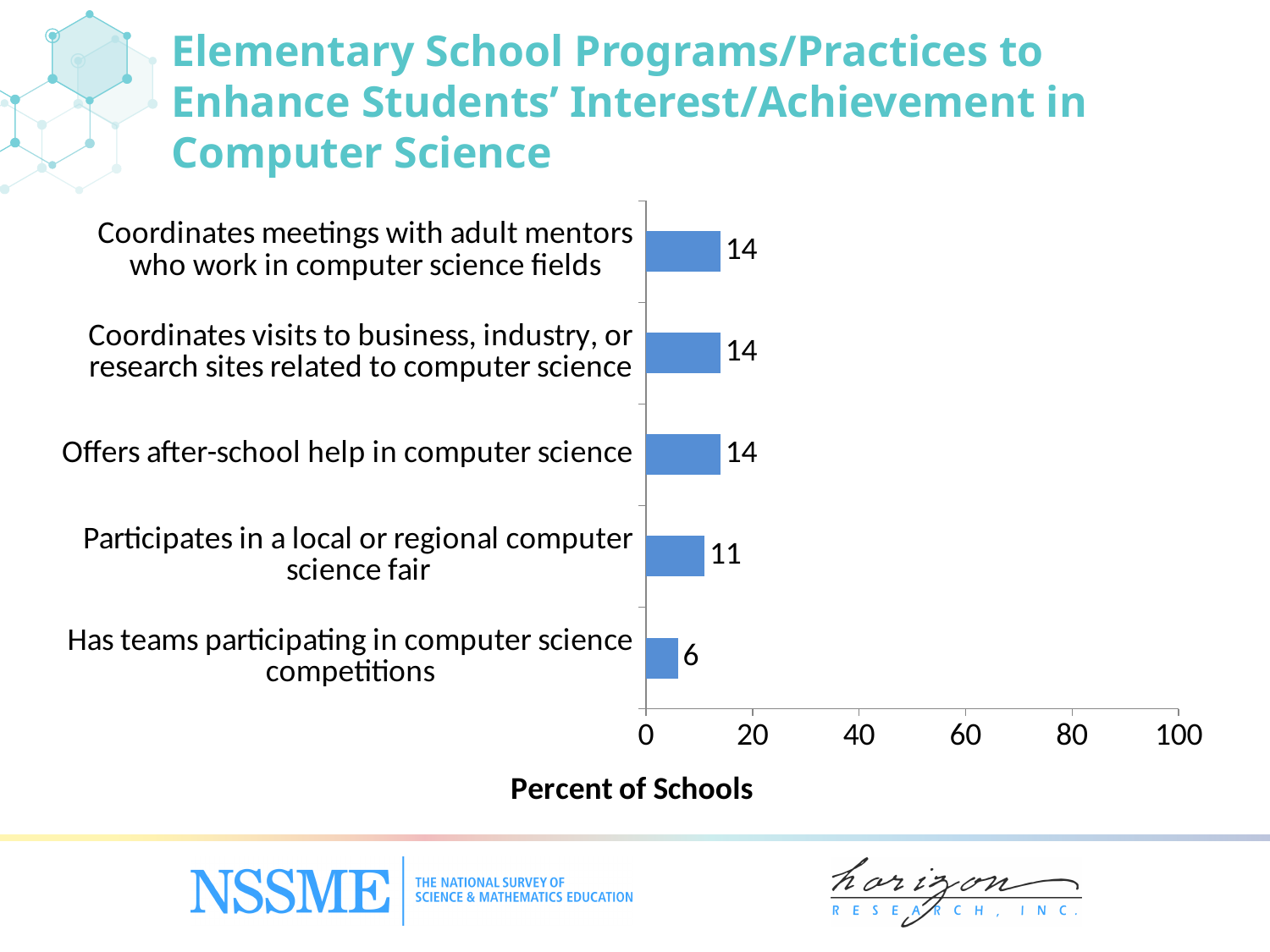
What kind of chart is shown on the slide? Bar chart What is the label of the horizontal axis? Percent of Schools What percent of schools offer after-school help in computer science? 14 Is the value for participating in a local or regional computer science fair greater or less than 20? less Which is larger: the percent of schools that coordinate visits to business, industry, or research sites related to computer science, or the percent that participate in a local or regional computer science fair? Coordinates visits to business, industry, or research sites related to computer science What is the difference in percent of schools between offering after-school help in computer science and having teams participating in computer science competitions? 8 What is the difference in percent of schools between participating in a local or regional computer science fair and having teams participating in computer science competitions? 5 How many programs/practices are shown in the chart? 5 Which program/practice has the lowest percent of schools? Has teams participating in computer science competitions What percent of schools have teams participating in computer science competitions? 6 What percent of schools coordinate meetings with adult mentors who work in computer science fields? 14 What percent of schools participate in a local or regional computer science fair? 11